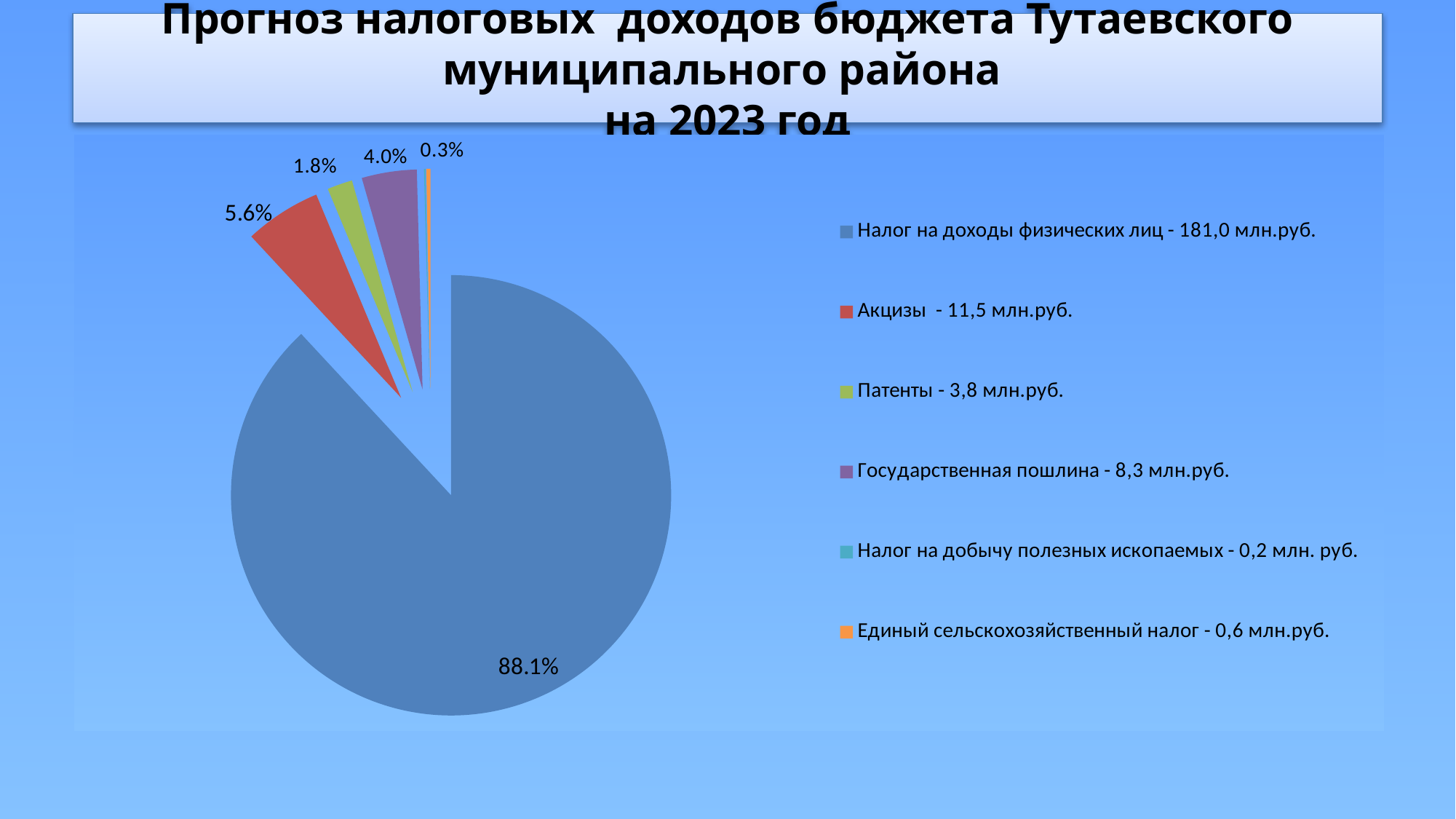
What share of the pie does Государственная пошлина take? 4.0% What share of the pie does Патенты take? 1.8% Which is larger: the slice for Акцизы or the slice for Государственная пошлина? Акцизы According to the legend, which category has the smallest value in млн.руб.? Налог на добычу полезных ископаемых According to the legend, what is the value for Акцизы? 11,5 млн.руб. How many categories does the legend of the pie chart list? 6 What share of the pie does Акцизы take? 5.6% By how many percentage points does the share of Налог на доходы физических лиц exceed the share of Акцизы? 82.5% Which category has the largest slice of the pie? Налог на доходы физических лиц According to the legend, what is the value for Государственная пошлина? 8,3 млн.руб. What kind of chart is shown on the slide? pie chart